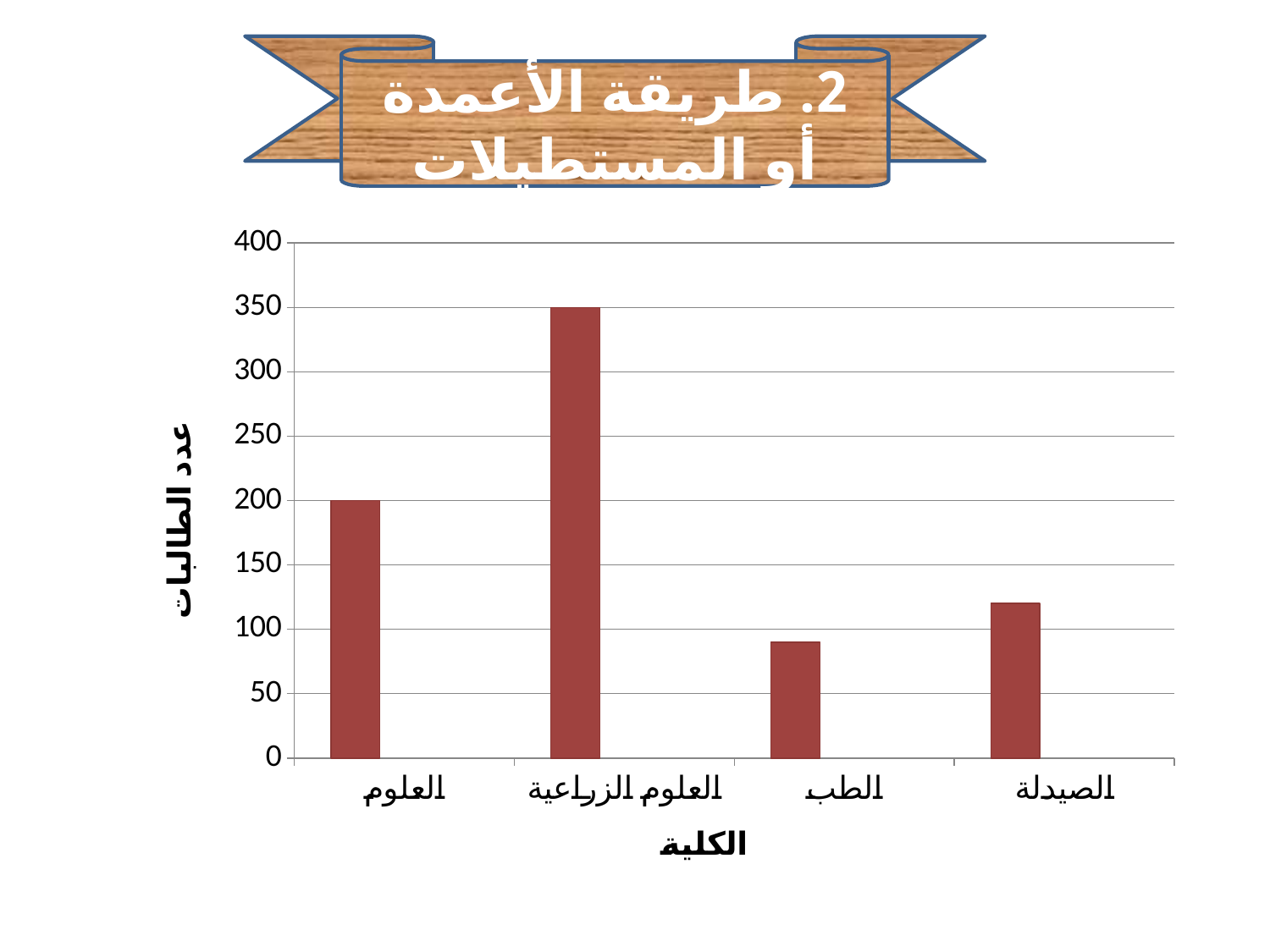
Which college has the lowest number of students? الطب Is the value for الصيدلة greater or less than 100? greater Which is larger, the value for الصيدلة or the value for الطب? الصيدلة What kind of chart is shown on the slide? bar chart Is the value for الطب greater or less than 100? less What is the label of the vertical axis? عدد الطالبات What is the value for العلوم? 200 Is the value for الصيدلة greater or less than 150? less How many colleges are shown on the x axis? 4 What is the difference between the values for العلوم الزراعية and العلوم? 150 What is the value for العلوم الزراعية? 350 Which college has the highest number of students? العلوم الزراعية